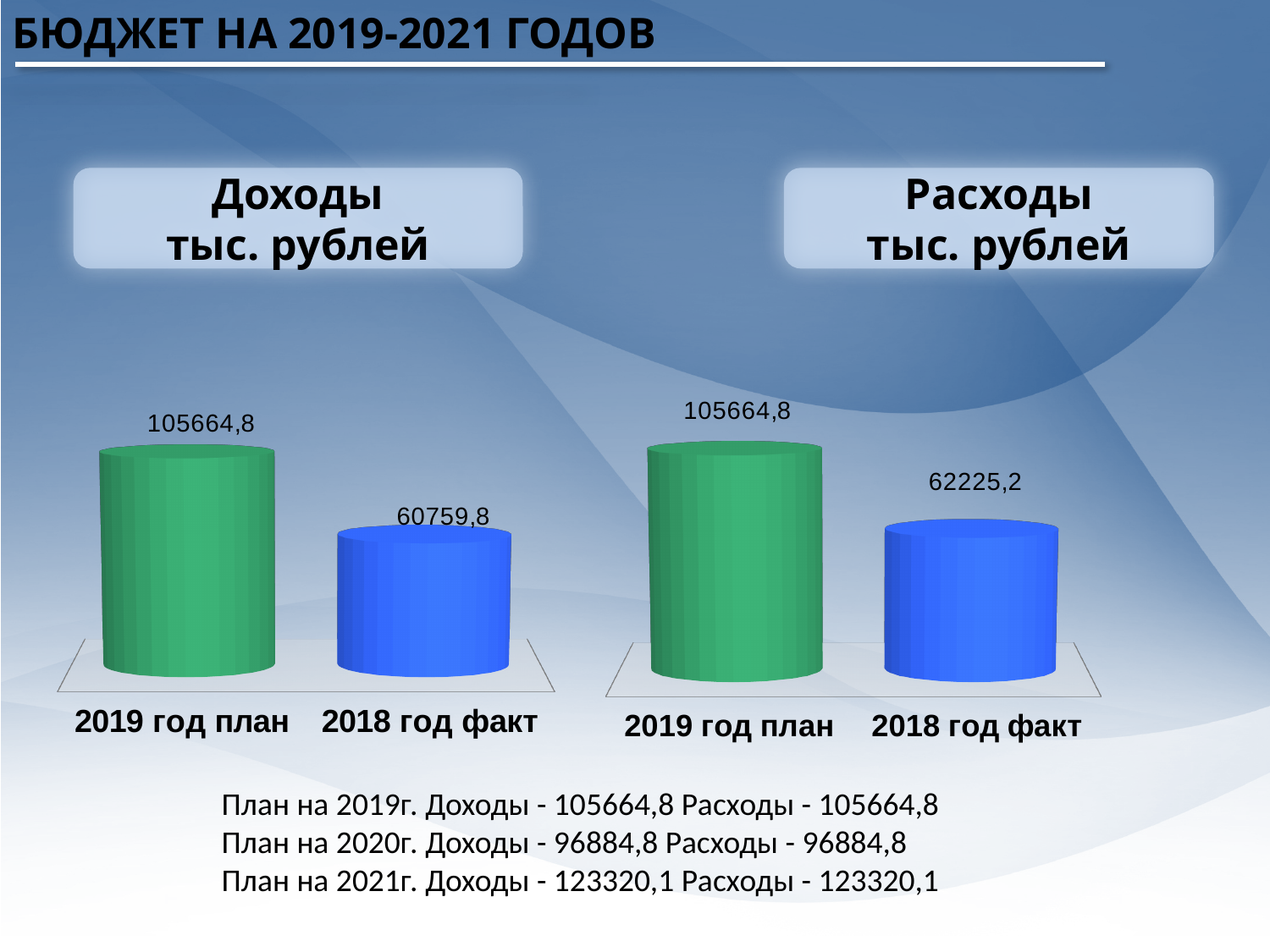
In the Доходы chart, what is the value for 2019 год план? 105664,8 In the Доходы chart, what is the value for 2018 год факт? 60759,8 In the Расходы chart, what is the value for 2018 год факт? 62225,2 In the Расходы chart, what is the value for 2019 год план? 105664,8 What kind of chart is the Расходы chart? bar chart In the Доходы chart, what colour is the bar for 2018 год факт? blue In the Доходы chart, what is the difference between 2019 год план and 2018 год факт? 44905,0 How many categories are shown in the Доходы chart? 2 In the Расходы chart, what is the difference between 2019 год план and 2018 год факт? 43439,6 In the Расходы chart, which is larger: 2019 год план or 2018 год факт? 2019 год план In the Расходы chart, which category has the lowest value? 2018 год факт In the Доходы chart, which category has the highest value? 2019 год план